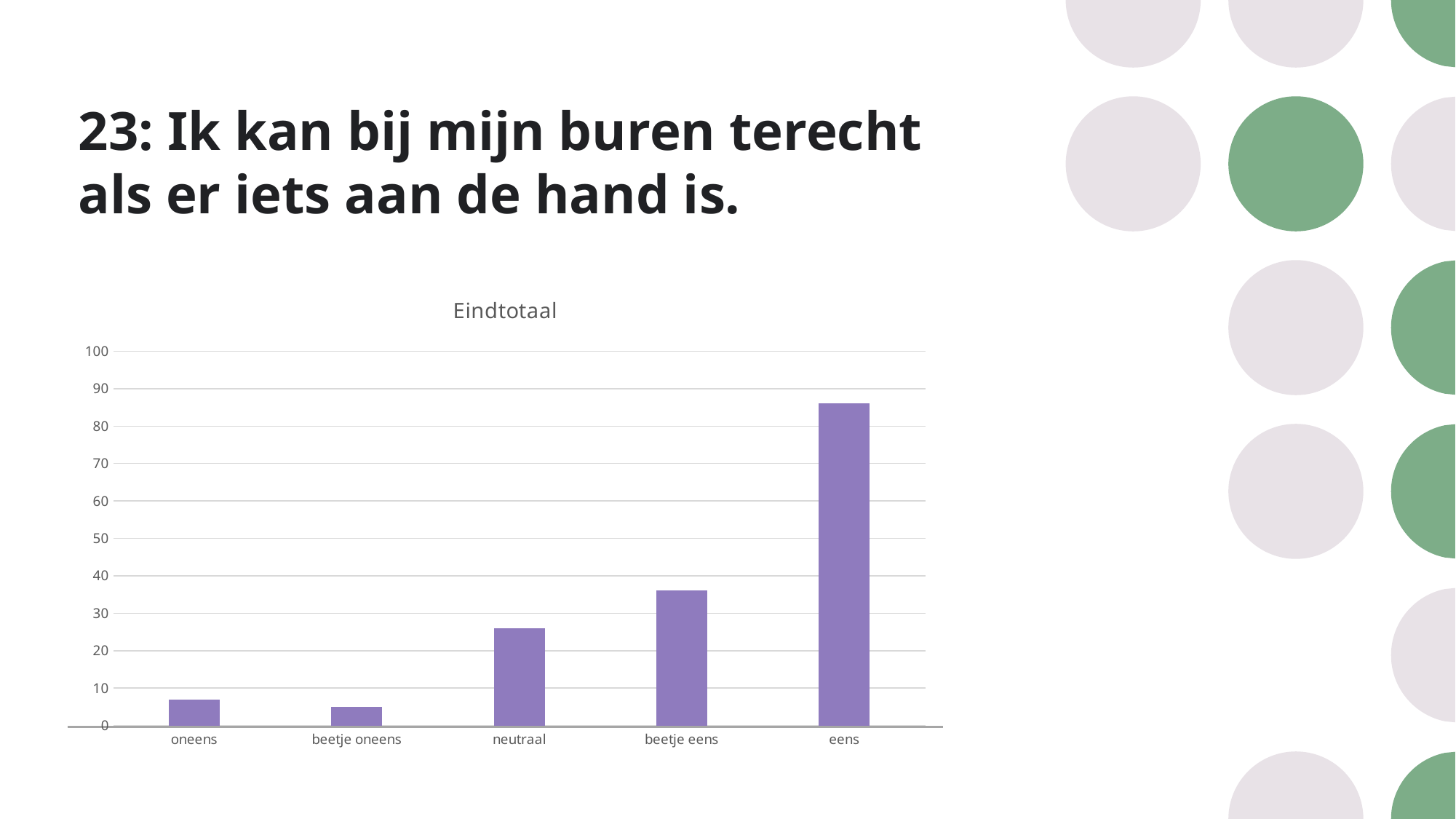
How many categories are shown on the x axis of the chart? 5 Which is larger, the value for neutraal or the value for beetje eens? beetje eens What type of chart is shown on the slide? bar chart Which is larger, the value for eens or the value for beetje eens? eens Is the value for oneens greater or less than 10? less Is the value for beetje eens greater or less than 40? less What is the title of the chart? Eindtotaal Is the value for beetje oneens greater or less than 10? less What colour are the bars in the chart? purple Which category has the highest value in the chart? eens